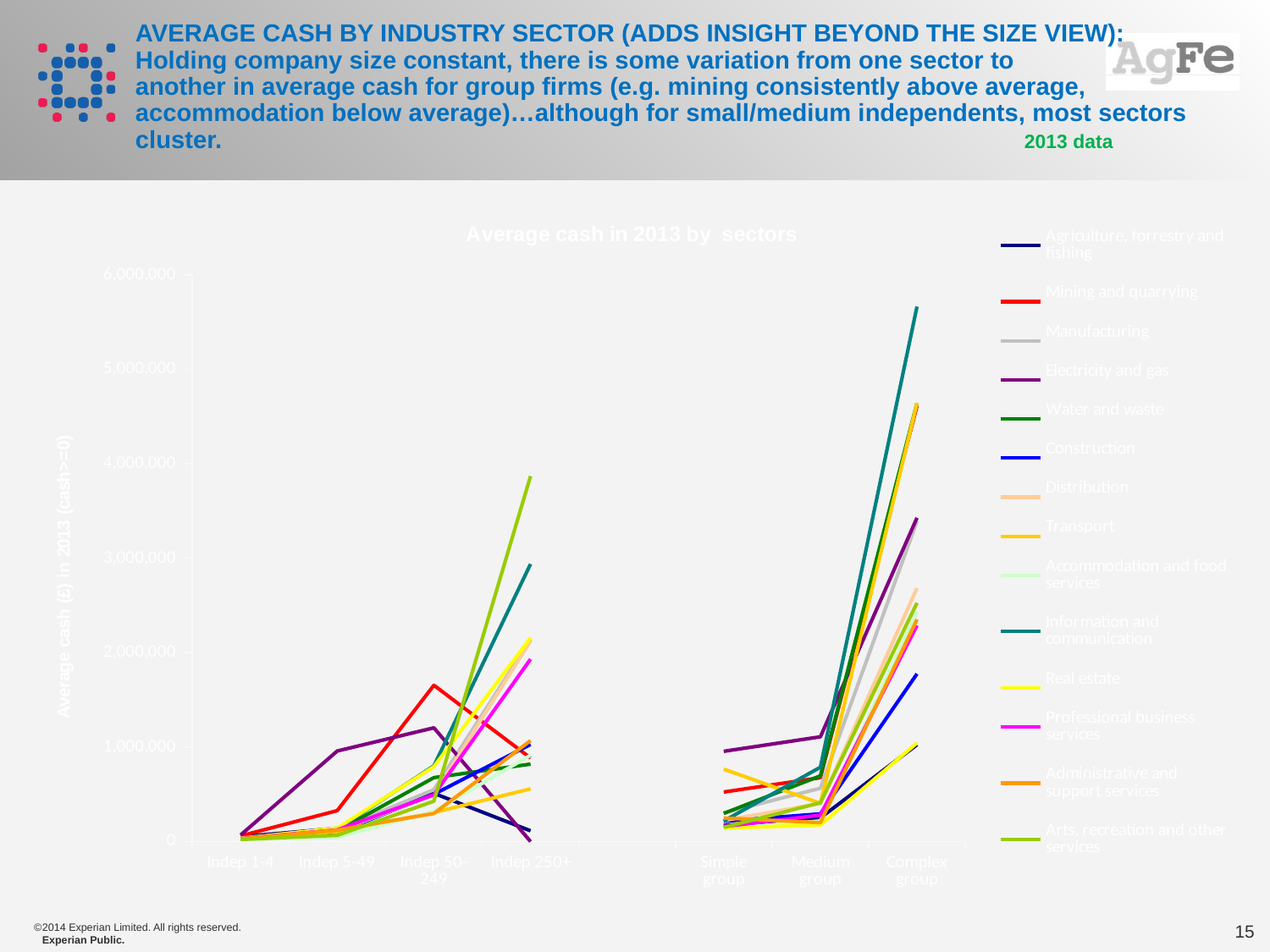
Which sector has the highest average cash for the Complex group category? Information and communication Does the Information and communication line rise or fall from Simple group to Complex group? Rise Is the value for Arts, recreation and other services at Indep 250+ greater or less than 3,000,000? greater How many categories are shown along the x axis of the chart? 7 Is the value for Information and communication at Complex group greater or less than 5,000,000? greater Is the value for Agriculture, forestry and fishing at Indep 250+ greater or less than 1,000,000? less What is the title of the chart? Average cash in 2013 by sectors How many series does the chart's legend list? 14 What kind of chart is shown on the slide? Line chart Which sector has the highest average cash for the Indep 250+ category? Arts, recreation and other services At Complex group, which is larger: Information and communication or Construction? Information and communication